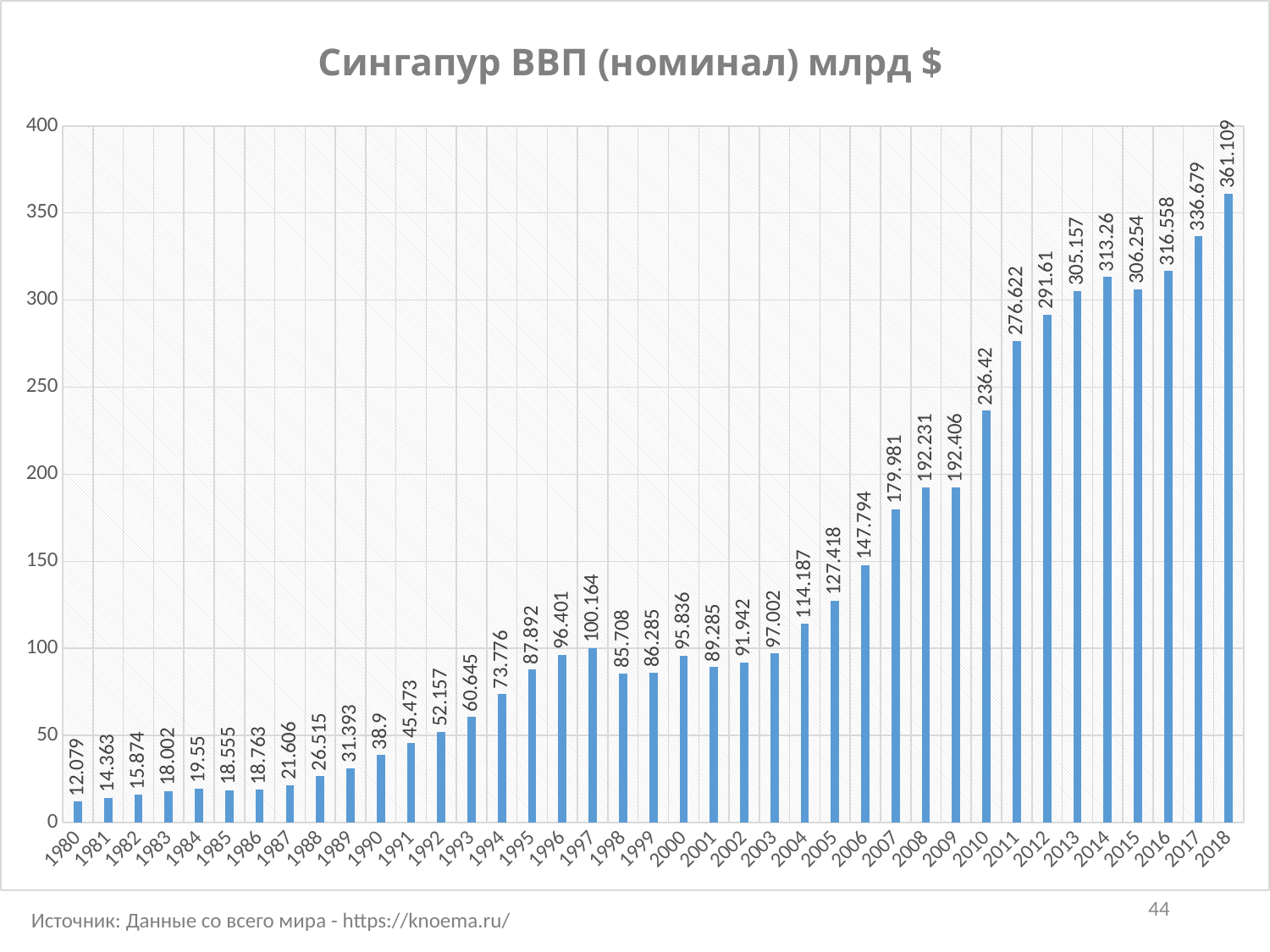
What is the value for 1985? 18.555 What is the difference between the values for 2018 and 2017? 24.43 Which is larger, the value for 2014 or the value for 2015? 2014 How many years are shown on the x axis? 39 Which year has the lowest value? 1980 What is the difference between the values for 2014 and 2015? 7.006 What kind of chart is this? bar chart What is the value for 1997? 100.164 What is the value for 2018? 361.109 Do the values generally rise or fall from 1980 to 2018? rise Is the value for 2010 greater or less than 200? greater Which year has the highest value? 2018